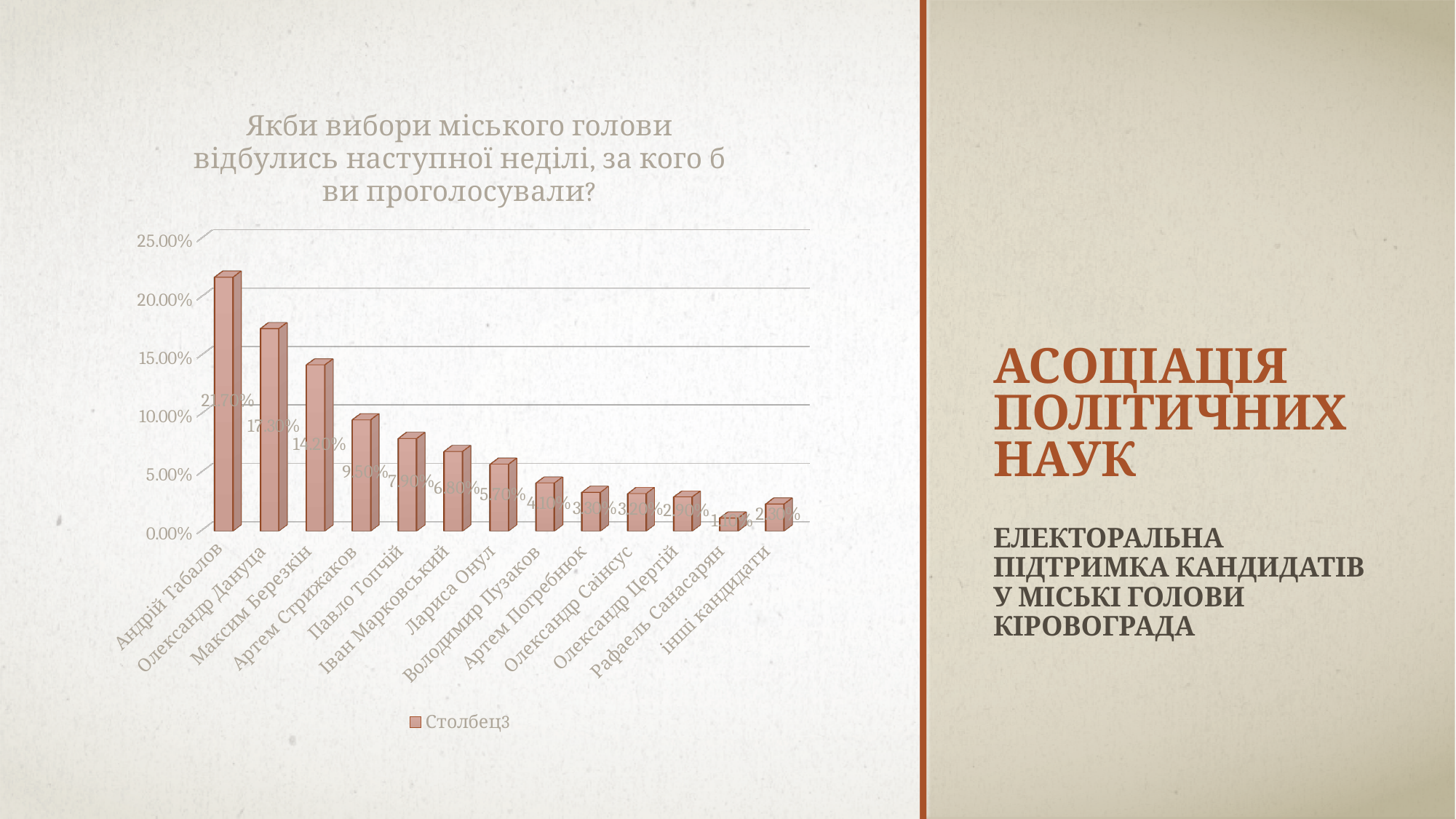
What percentage would vote for Андрій Табалов? 21.70% What kind of chart is shown on the slide? bar chart What is the value shown for Олександр Дануца? 17.30% Is the value for Максим Березкін greater or less than 15.00%? less What percentage is shown for Артем Стрижаков? 9.50% Which candidate has the highest value in the chart? Андрій Табалов What is the value for the category 'інші кандидати'? 2.30% How many series does the legend list? 1 How many categories are shown on the x axis of the chart? 13 Which candidate has the lowest value in the chart? Рафаель Санасарян What is the difference between the values for Андрій Табалов and Олександр Дануца? 4.40% Who has the larger value, Павло Топчій or Іван Марковський? Павло Топчій